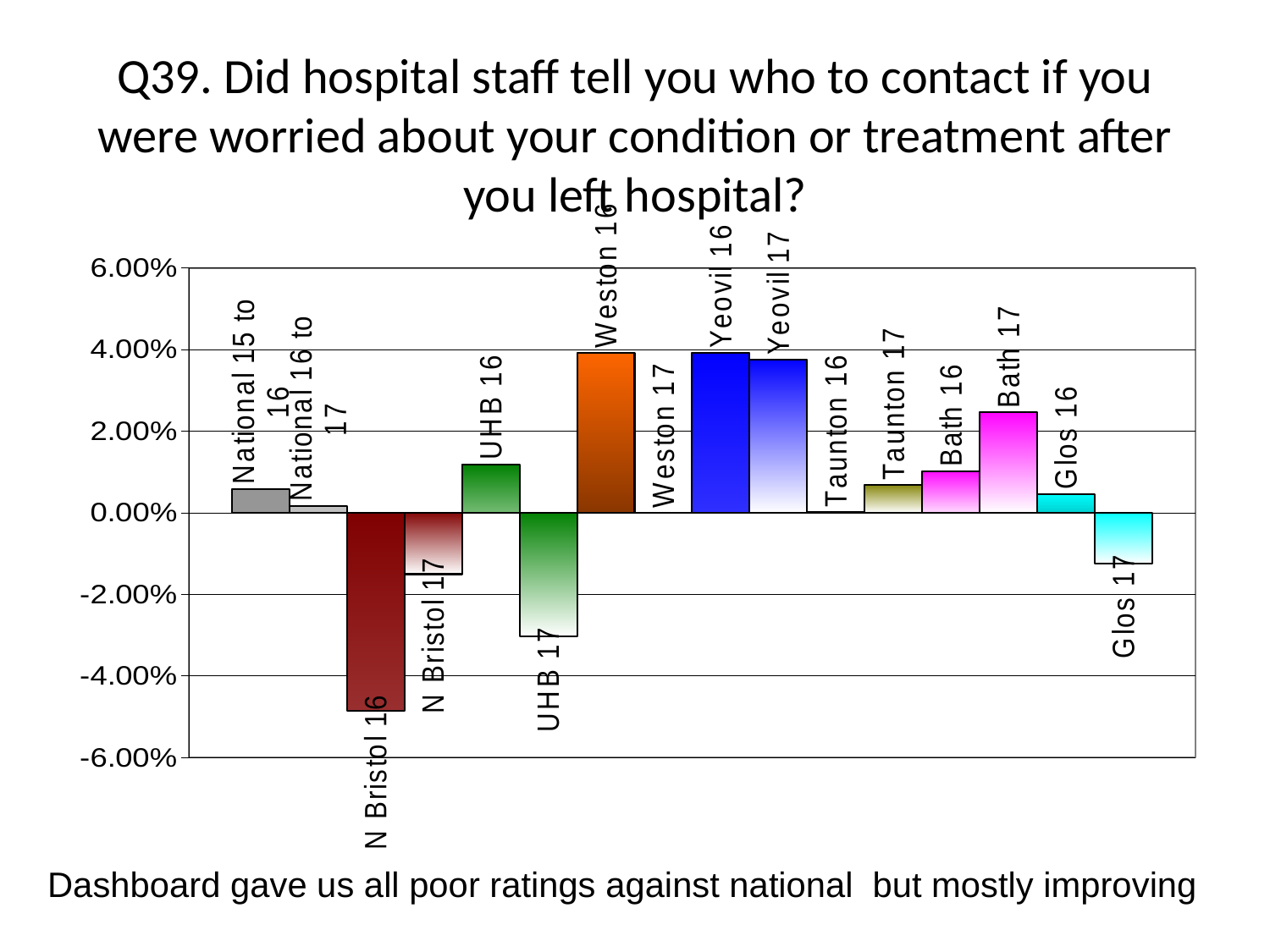
Is the value for Glos 17 greater or less than 0.00%? less Which category has the lowest value in the chart? N Bristol 16 Is the value for N Bristol 16 greater or less than -4.00%? less Which is larger, the value for UHB 16 or the value for UHB 17? UHB 16 What kind of chart is shown on the slide? Bar chart Is the value for Bath 17 greater or less than 2.00%? greater Which is larger, the value for N Bristol 16 or the value for N Bristol 17? N Bristol 17 Which is larger, the value for Bath 16 or the value for Bath 17? Bath 17 What is the title of the chart on the slide? Q39. Did hospital staff tell you who to contact if you were worried about your condition or treatment after you left hospital?